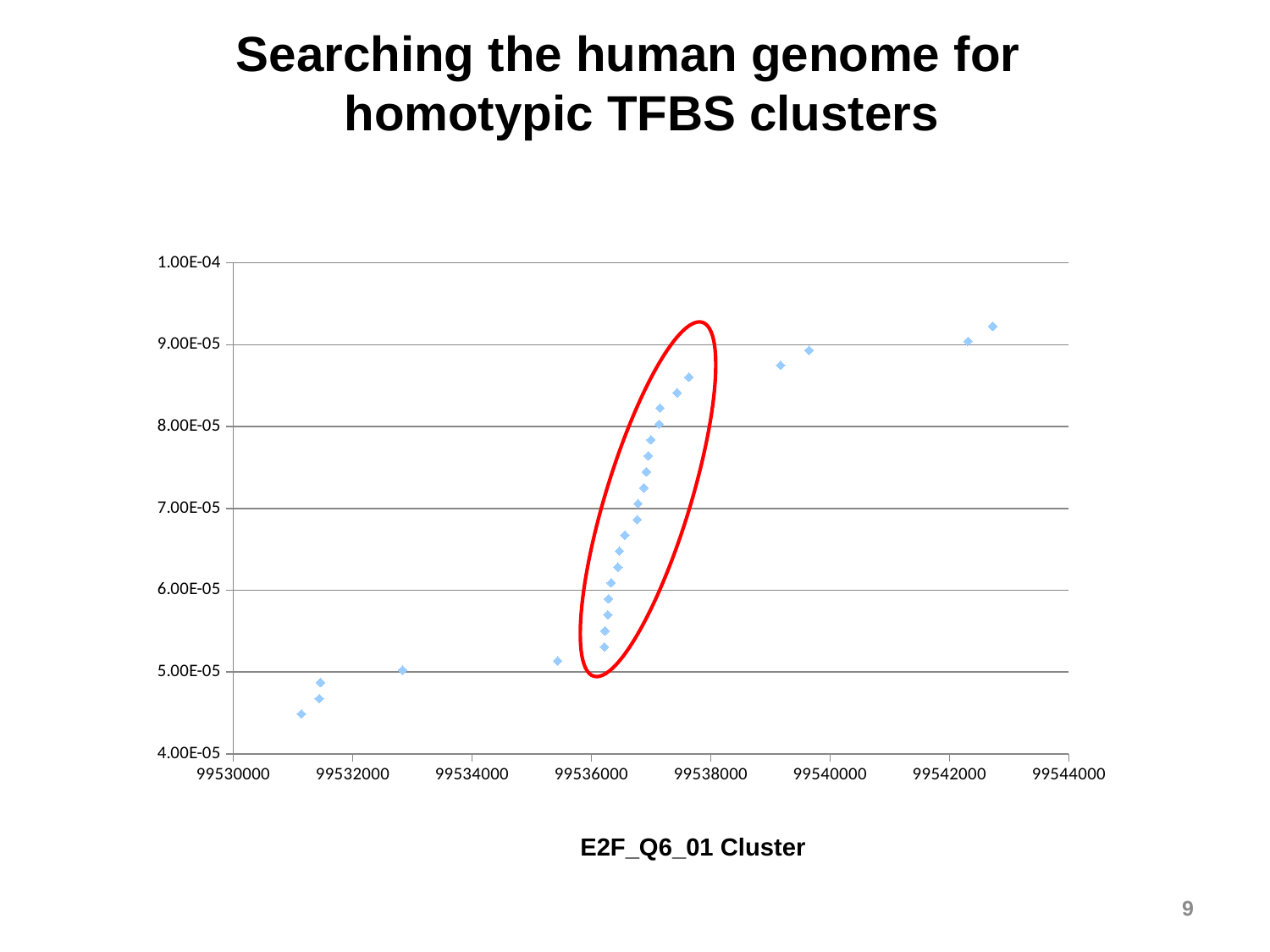
What is the lowest value shown on the y axis? 4.00E-05 What colour is the ellipse drawn around the dense group of points? red Do the plotted values generally rise or fall as the x-axis value increases? rise What kind of chart is shown on the slide? scatter chart Is the value of the leftmost point greater or less than 5.00E-05? less What label appears below the chart? E2F_Q6_01 Cluster Is the value of the rightmost point greater or less than 9.00E-05? greater